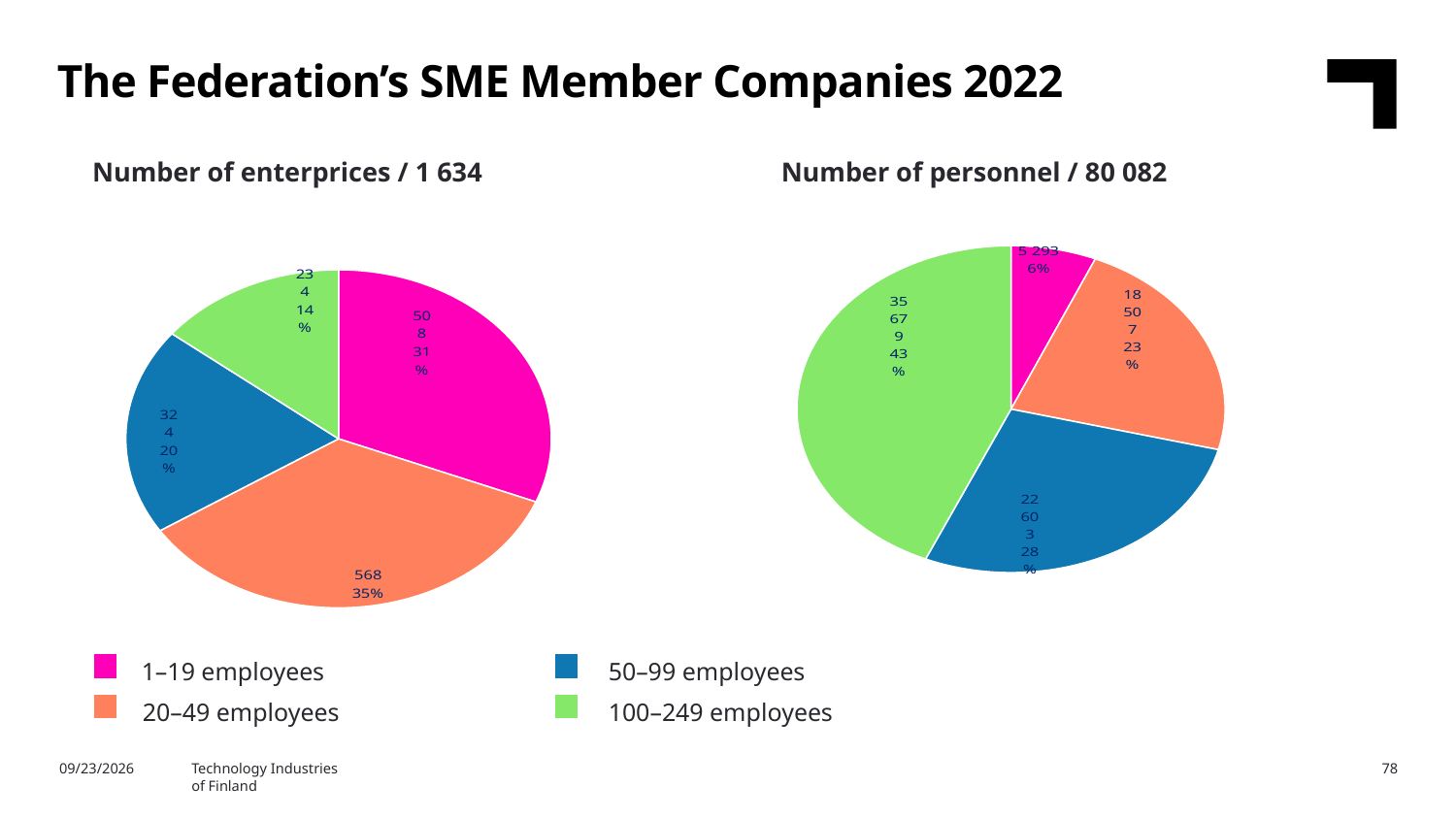
In the 'Number of personnel / 80 082' chart, how many personnel are in companies with 1–19 employees? 5 293 What kind of chart is the 'Number of enterprices / 1 634' chart? pie chart In the 'Number of enterprices / 1 634' chart, which category has the smallest slice? 100–249 employees How many categories does the legend list? 4 In the 'Number of enterprices / 1 634' chart, how many percentage points larger is the 20–49 employees share than the 1–19 employees share? 4 percentage points In the 'Number of enterprices / 1 634' chart, what share of the pie do companies with 20–49 employees make up? 35% In the 'Number of personnel / 80 082' chart, which slice is larger: 50–99 employees or 20–49 employees? 50–99 employees In the 'Number of enterprices / 1 634' chart, which category has the largest slice? 20–49 employees In the 'Number of personnel / 80 082' chart, what share of the pie do companies with 100–249 employees make up? 43% In the 'Number of personnel / 80 082' chart, which category has the smallest slice? 1–19 employees In the 'Number of enterprices / 1 634' chart, how many enterprises have 20–49 employees? 568 In the 'Number of personnel / 80 082' chart, which category has the largest slice? 100–249 employees